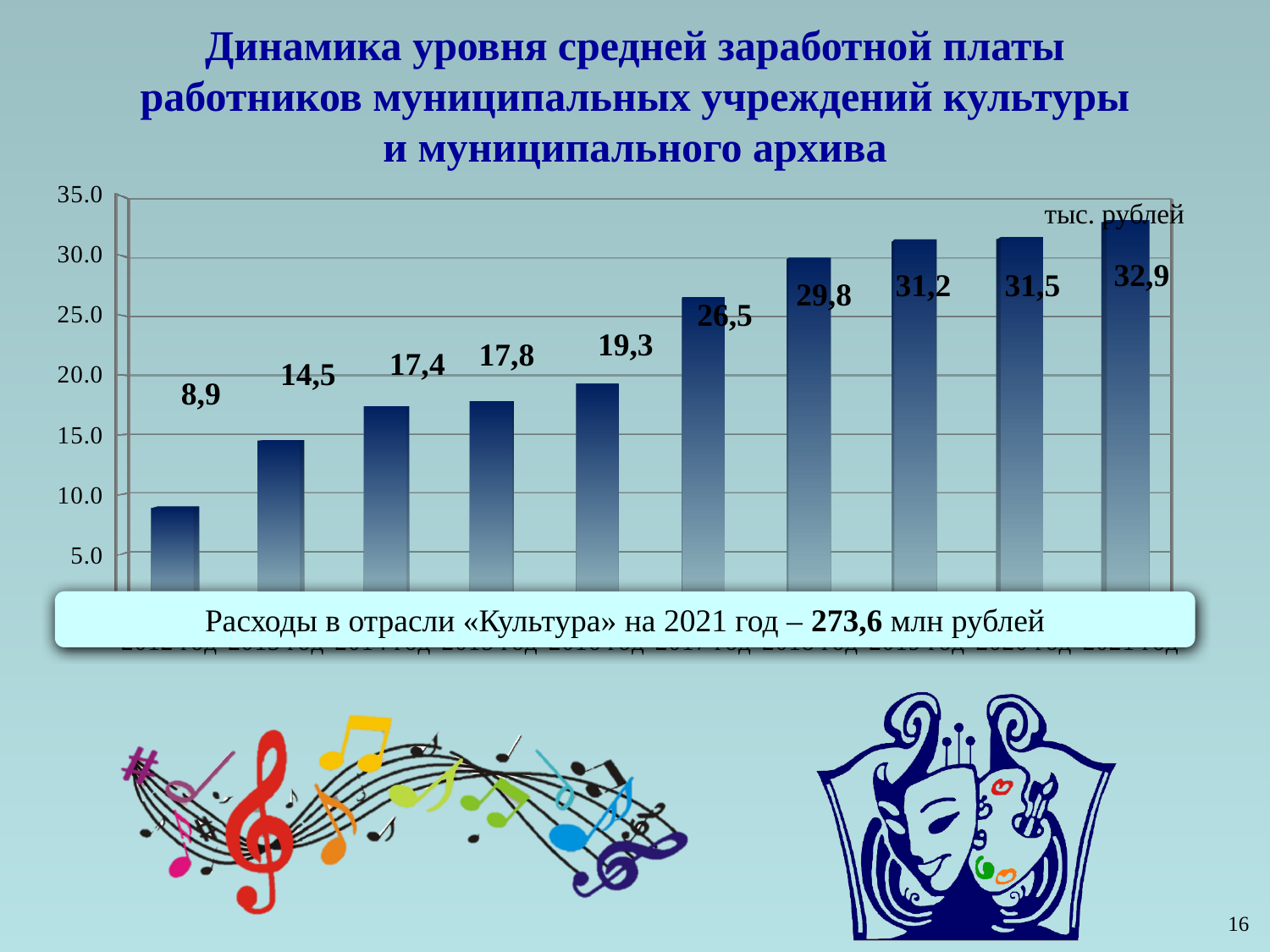
Which bar has the lowest value in the chart? the first (leftmost) bar, 8,9 What is the difference between the highest value (32,9) and the lowest value (8,9) in the chart? 24,0 What unit is indicated in the top right corner of the chart? тыс. рублей Which is larger: the value of the third bar (17,4) or the fourth bar (17,8)? 17,8 (the fourth bar) What is the value of the fifth bar from the left in the chart? 19,3 What is the value of the first (leftmost) bar in the chart? 8,9 How many bars are plotted in the chart? 10 What type of chart is shown on the slide? bar chart What is the difference between the sixth bar (26,5) and the fifth bar (19,3)? 7,2 Do the values in the chart rise or fall from left to right? rise What is the value of the last (rightmost) bar in the chart? 32,9 Which bar has the highest value in the chart? the last (rightmost) bar, 32,9